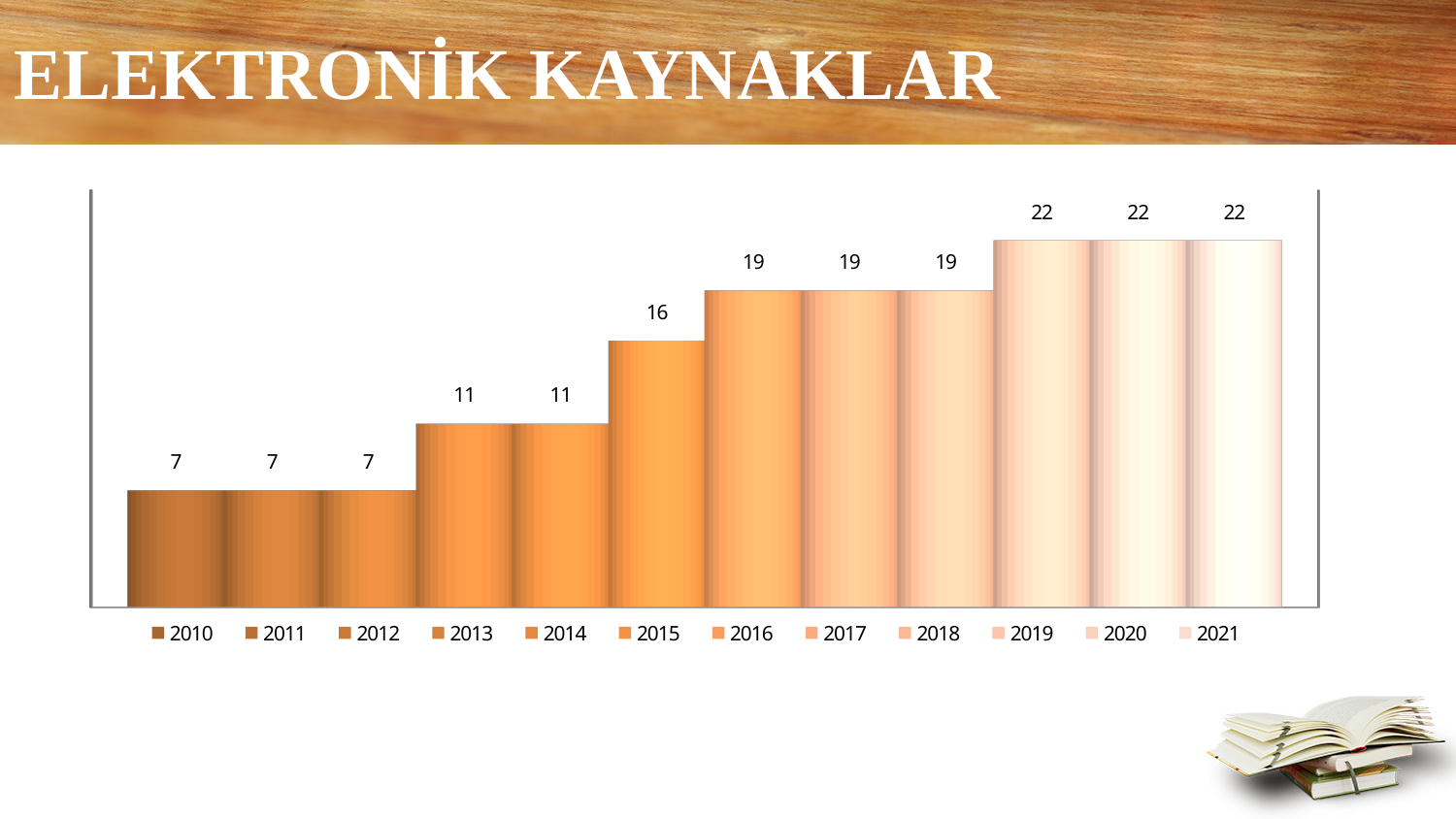
Do the values rise or fall from 2010 to 2021? rise What is the value for 2010? 7 What is the difference between the values for 2016 and 2014? 8 What is the value for 2015? 16 How many years are shown in the legend? 12 What kind of chart is shown on the slide? bar chart What is the difference between the values for 2019 and 2012? 15 What is the value for 2017? 19 What is the lowest value shown in the chart? 7 Which is larger, the value for 2013 or the value for 2018? 2018 What is the title of the slide? ELEKTRONİK KAYNAKLAR What is the value for 2021? 22